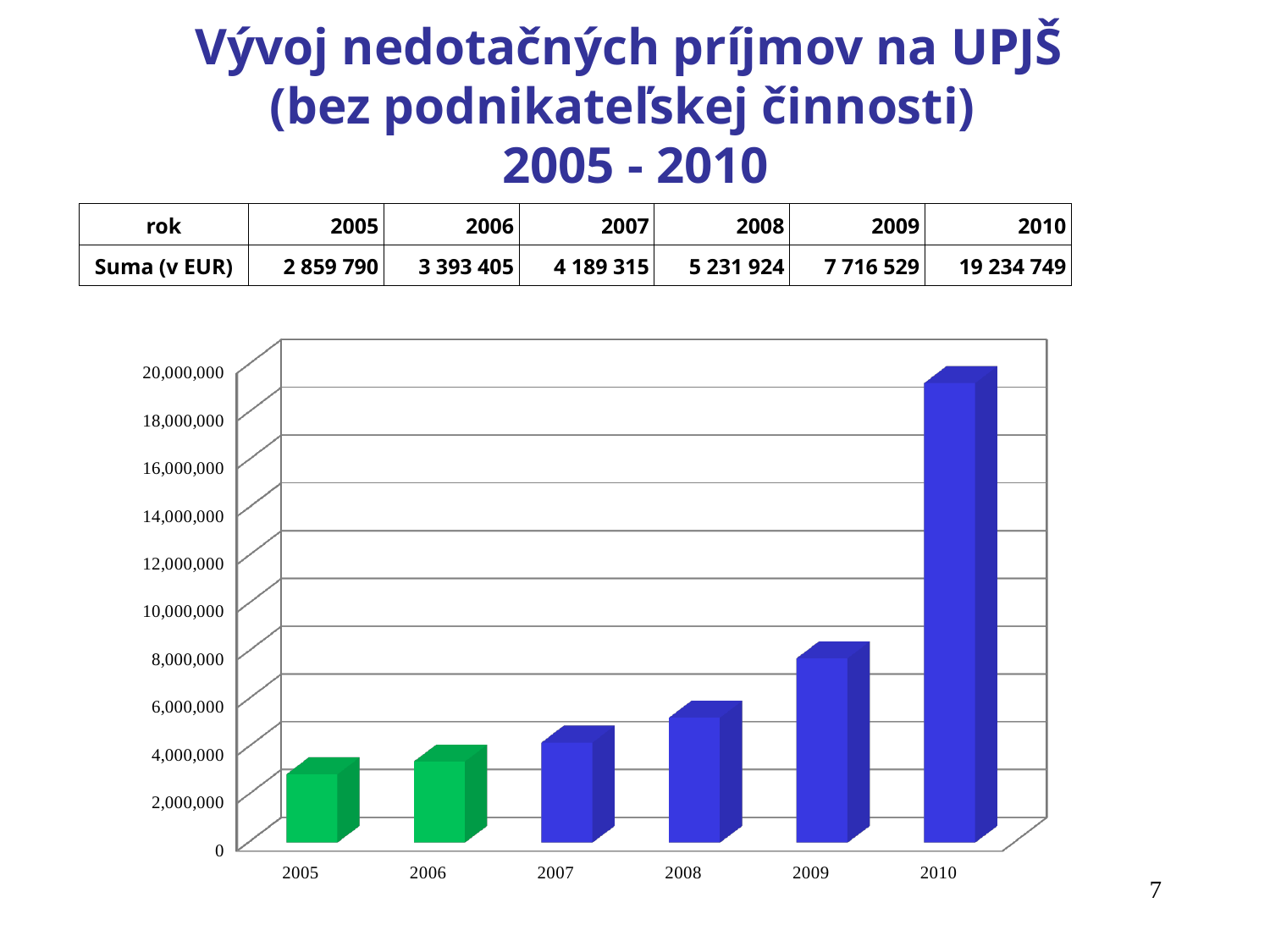
What is the value (Suma v EUR) for 2010? 19 234 749 Do the values rise or fall from 2005 to 2010? rise How many years are plotted on the chart? 6 Is the value for 2009 greater or less than 8,000,000? less Which is larger, the value for 2008 or the value for 2009? 2009 Is the value for 2010 greater or less than 18,000,000? greater Which year has the lowest value on the chart? 2005 Which year has the highest value on the chart? 2010 What is the value (Suma v EUR) for 2007? 4 189 315 What is the difference between the values for 2006 and 2005? 533 615 What type of chart is shown on the slide? bar chart What is the value (Suma v EUR) for 2005? 2 859 790